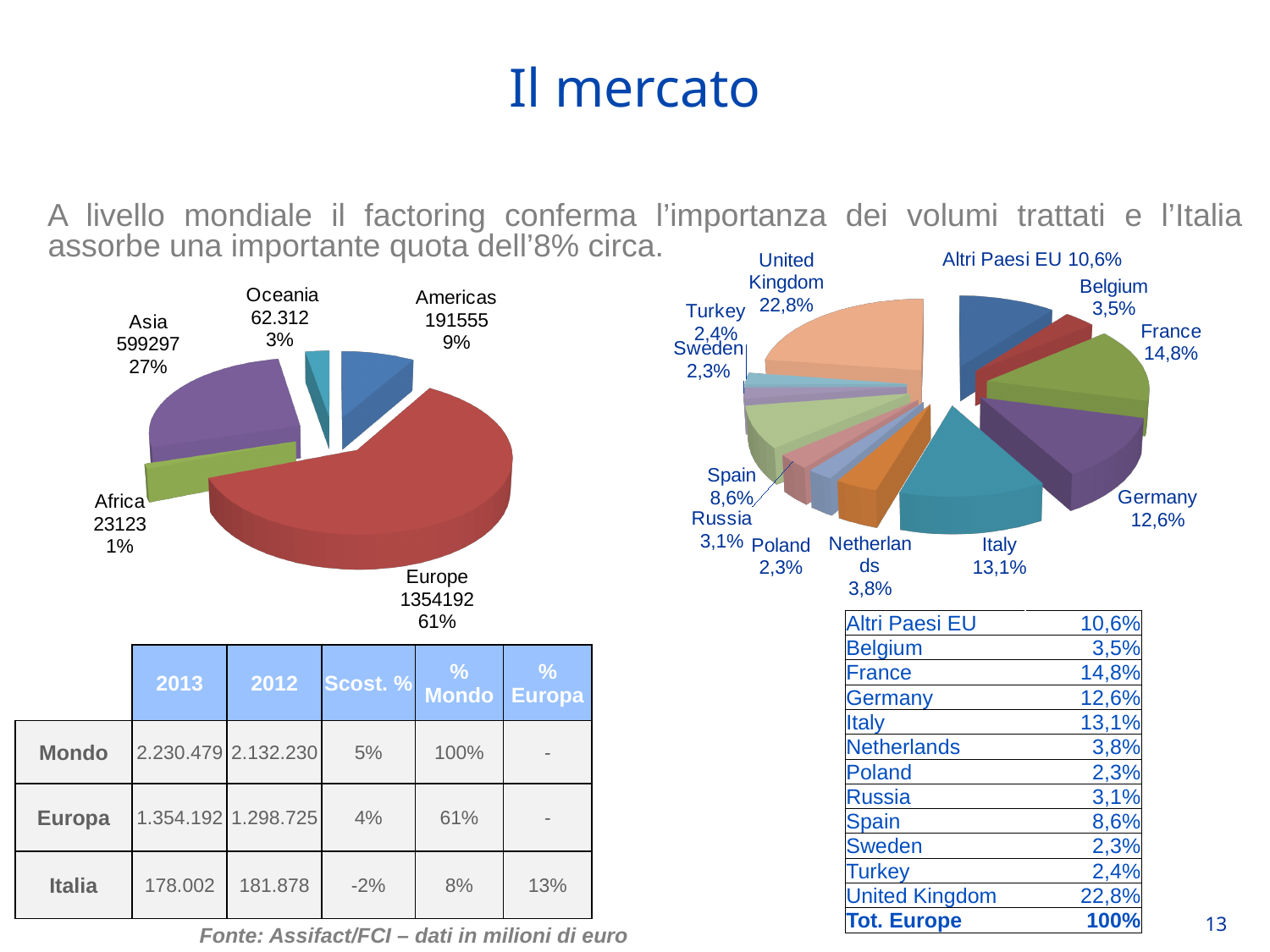
In the right-hand pie chart of European countries, what is the share for United Kingdom? 22,8% How many slices does the right-hand pie chart of European countries have? 12 In the left-hand pie chart of world regions, what is the value shown for Asia? 599297 In the right-hand pie chart of European countries, what is the difference between the shares of France and Germany? 2,2% What kind of chart is the left-hand chart showing world regions? pie chart In the right-hand pie chart of European countries, which country has the largest slice? United Kingdom In the right-hand pie chart of European countries, what is the share for Netherlands? 3,8% In the right-hand pie chart of European countries, which is larger, Italy or Spain? Italy In the left-hand pie chart of world regions, which region has the smallest slice? Africa In the left-hand pie chart of world regions, what share does Europe hold? 61% In the left-hand pie chart of world regions, which is larger, Americas or Oceania? Americas How many slices does the left-hand pie chart of world regions have? 5